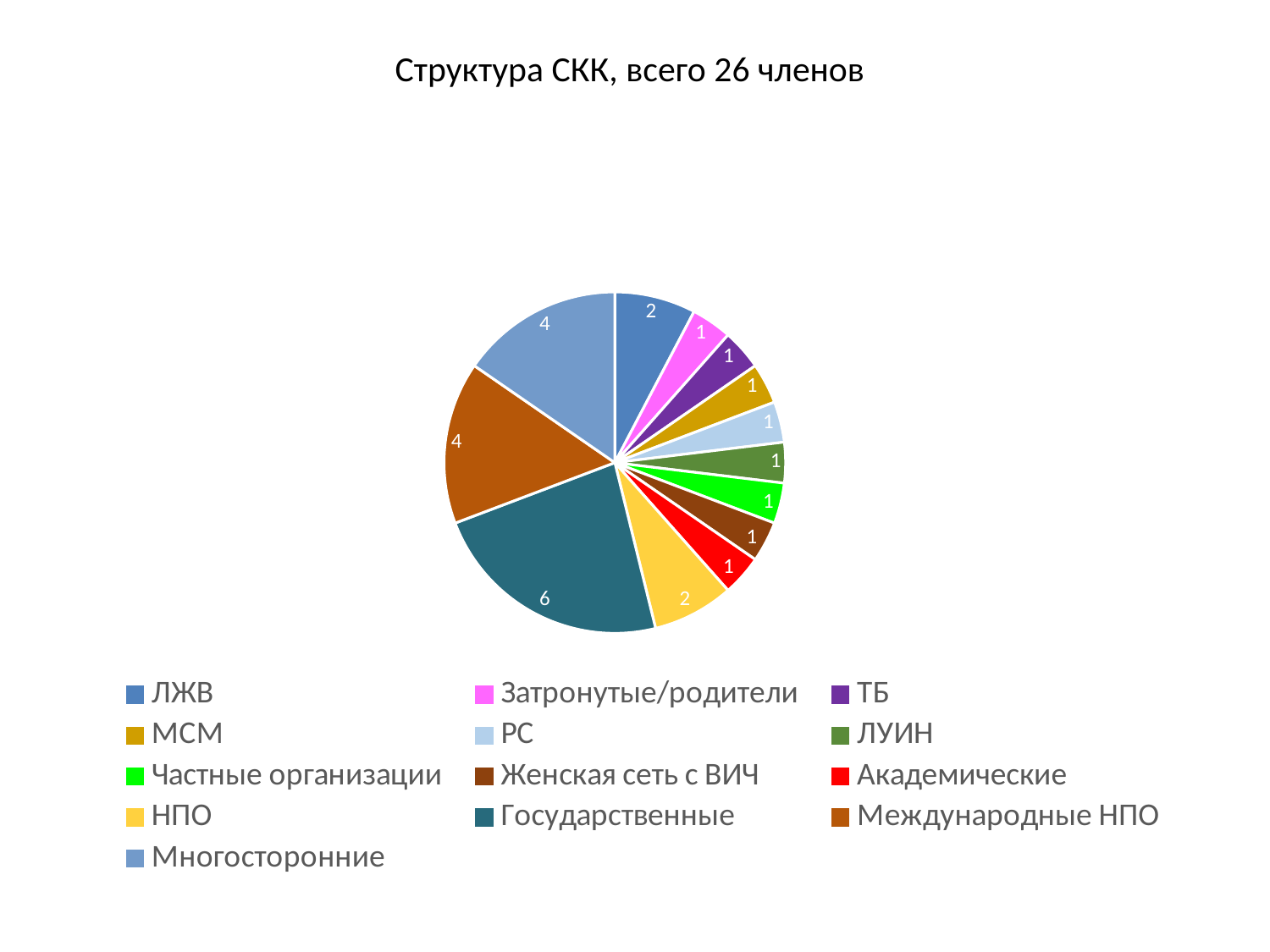
What is the value for Государственные? 6 How many categories does the legend list? 13 What type of chart is shown on the slide? Pie chart What is the title of the chart? Структура СКК, всего 26 членов What is the value for Международные НПО? 4 Which category has the largest slice? Государственные Which is larger, the value for ЛЖВ or the value for ТБ? ЛЖВ What is the total number of members shown in the chart? 26 What is the value for ЛЖВ? 2 What is the difference between the values for Государственные and Многосторонние? 2 What is the value for НПО? 2 What fraction of the total members does Государственные represent? 6 out of 26